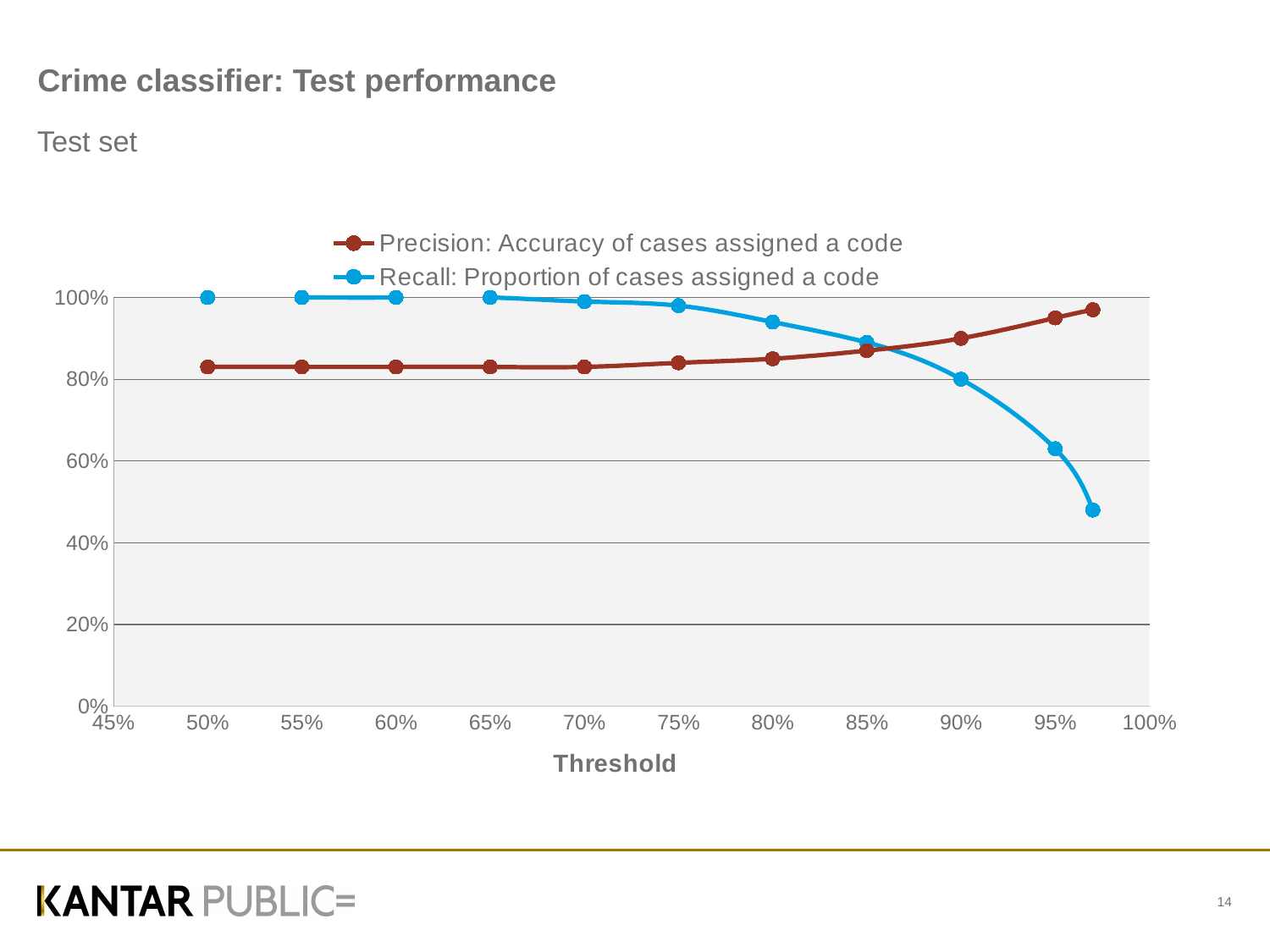
What is the Recall value at a threshold of 65%? 100% At a threshold of 95%, which series has the larger value, Precision or Recall? Precision What is the label on the x axis? Threshold How many data points are plotted for the Precision series? 11 Does the Precision series rise or fall as the threshold increases? rise How many series does the legend list? 2 What is the Recall value at a threshold of 50%? 100% What kind of chart is shown on the slide? line chart Does the Recall series rise or fall as the threshold increases? fall